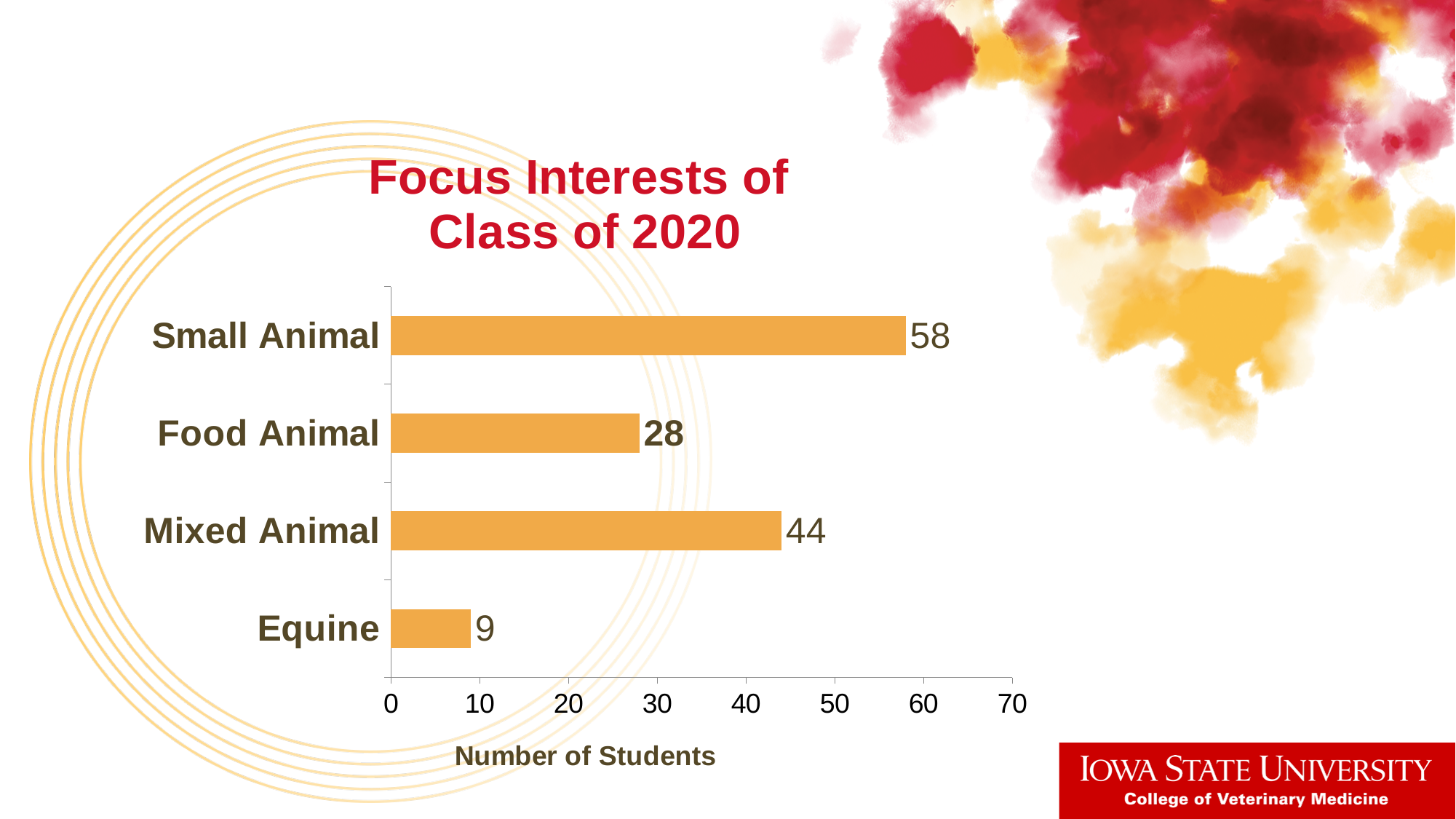
Is the value for Food Animal greater or less than 30? less How many focus interest categories are shown in the chart? 4 Which focus interest has the highest number of students? Small Animal What is the number of students for Food Animal? 28 How many students chose Equine? 9 Which focus interest has the lowest number of students? Equine What is the value for Mixed Animal? 44 How many students have Small Animal as their focus interest? 58 Which has more students, Food Animal or Mixed Animal? Mixed Animal What is the title of the chart? Focus Interests of Class of 2020 What is the difference between the number of students for Small Animal and Mixed Animal? 14 What kind of chart is shown on the slide? bar chart